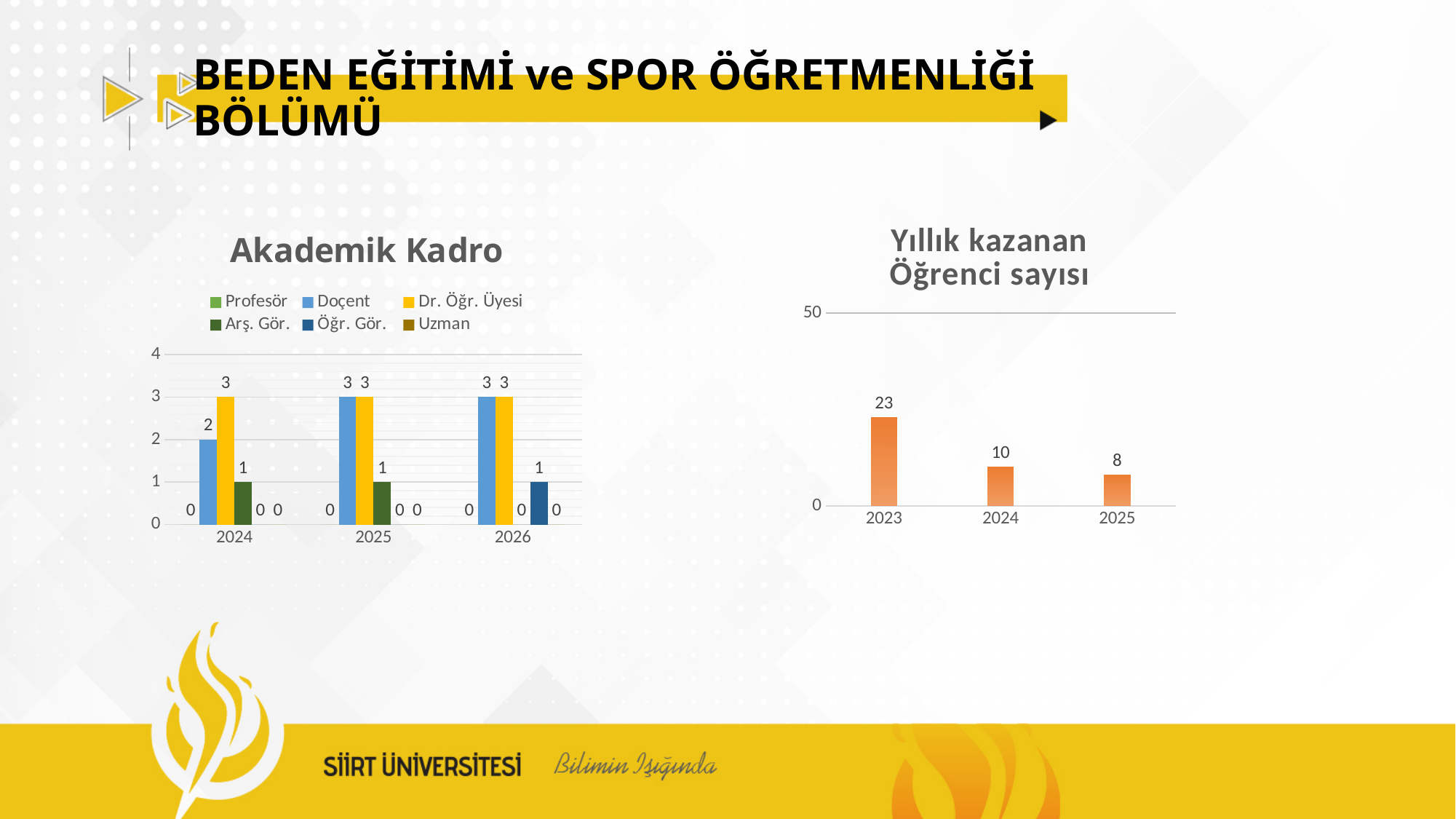
In the 'Yıllık kazanan Öğrenci sayısı' chart, do the values rise or fall from 2023 to 2025? fall In the 'Yıllık kazanan Öğrenci sayısı' chart, what is the value for 2023? 23 What kind of chart is the 'Yıllık kazanan Öğrenci sayısı' chart? bar chart In the 'Akademik Kadro' chart, what is the value for Öğr. Gör. in 2026? 1 In the 'Akademik Kadro' chart, how many series does the legend list? 6 In the 'Akademik Kadro' chart, which is larger in 2024: Doçent or Arş. Gör.? Doçent In the 'Akademik Kadro' chart, what is the value for Doçent in 2024? 2 In the 'Akademik Kadro' chart, what is the value for Dr. Öğr. Üyesi in 2025? 3 In the 'Yıllık kazanan Öğrenci sayısı' chart, what is the difference between 2023 and 2024? 13 In the 'Akademik Kadro' chart, how many year categories are shown on the x axis? 3 In the 'Yıllık kazanan Öğrenci sayısı' chart, which year has the lowest value? 2025 In the 'Akademik Kadro' chart, what is the difference between Dr. Öğr. Üyesi and Doçent in 2024? 1